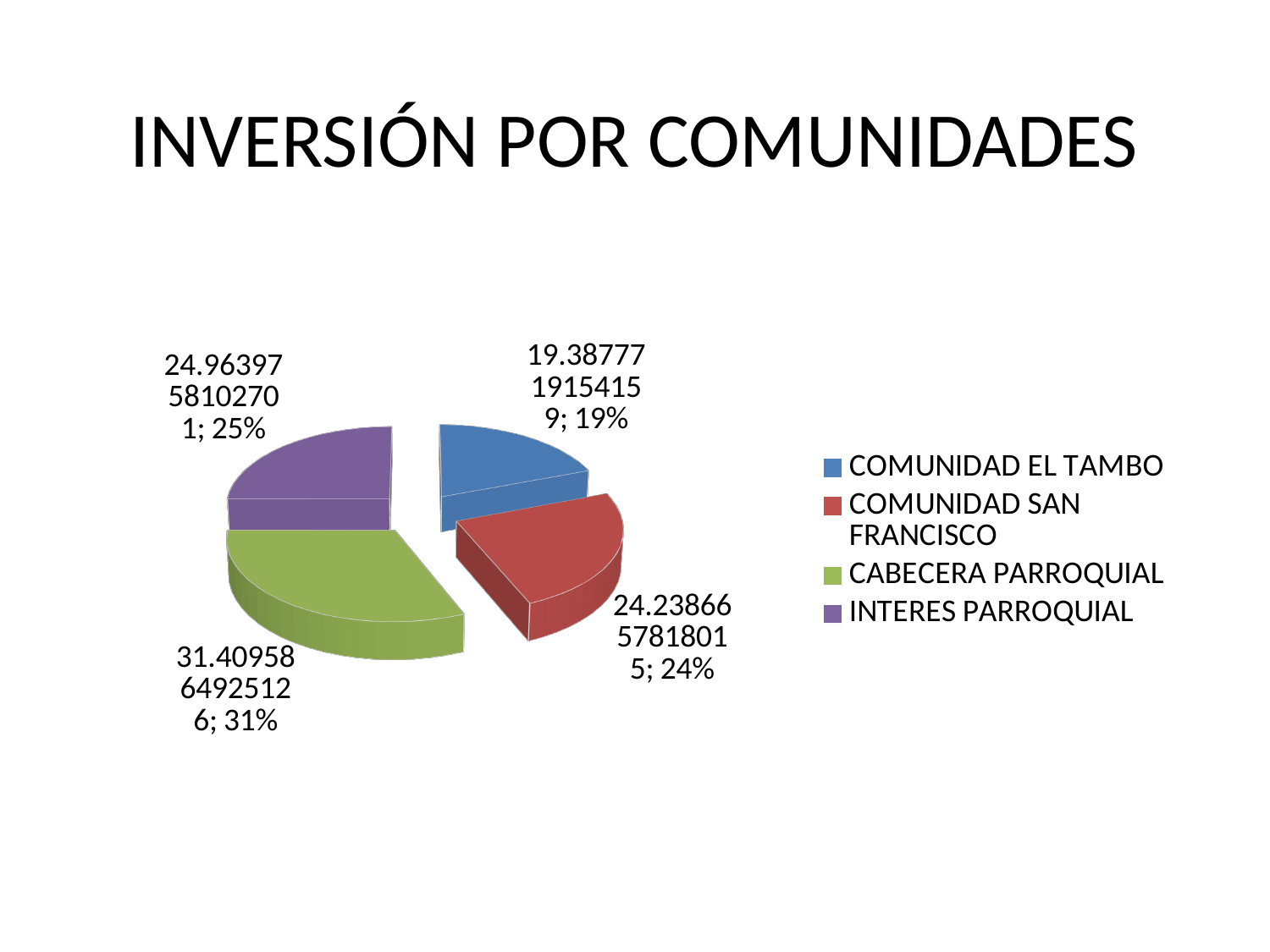
What percentage share of the pie does INTERES PARROQUIAL have? 25% What colour is the CABECERA PARROQUIAL slice? Green What percentage share of the pie does COMUNIDAD EL TAMBO have? 19% What percentage share of the pie does CABECERA PARROQUIAL have? 31% What is the title of the slide? INVERSIÓN POR COMUNIDADES Which has the larger share, INTERES PARROQUIAL or COMUNIDAD SAN FRANCISCO? INTERES PARROQUIAL What kind of chart is shown on the slide? Pie chart Which category has the smallest share of the pie? COMUNIDAD EL TAMBO Which category has the largest share of the pie? CABECERA PARROQUIAL How many slices does the pie chart have? 4 By how many percentage points does the share of CABECERA PARROQUIAL exceed that of COMUNIDAD EL TAMBO? 12 percentage points